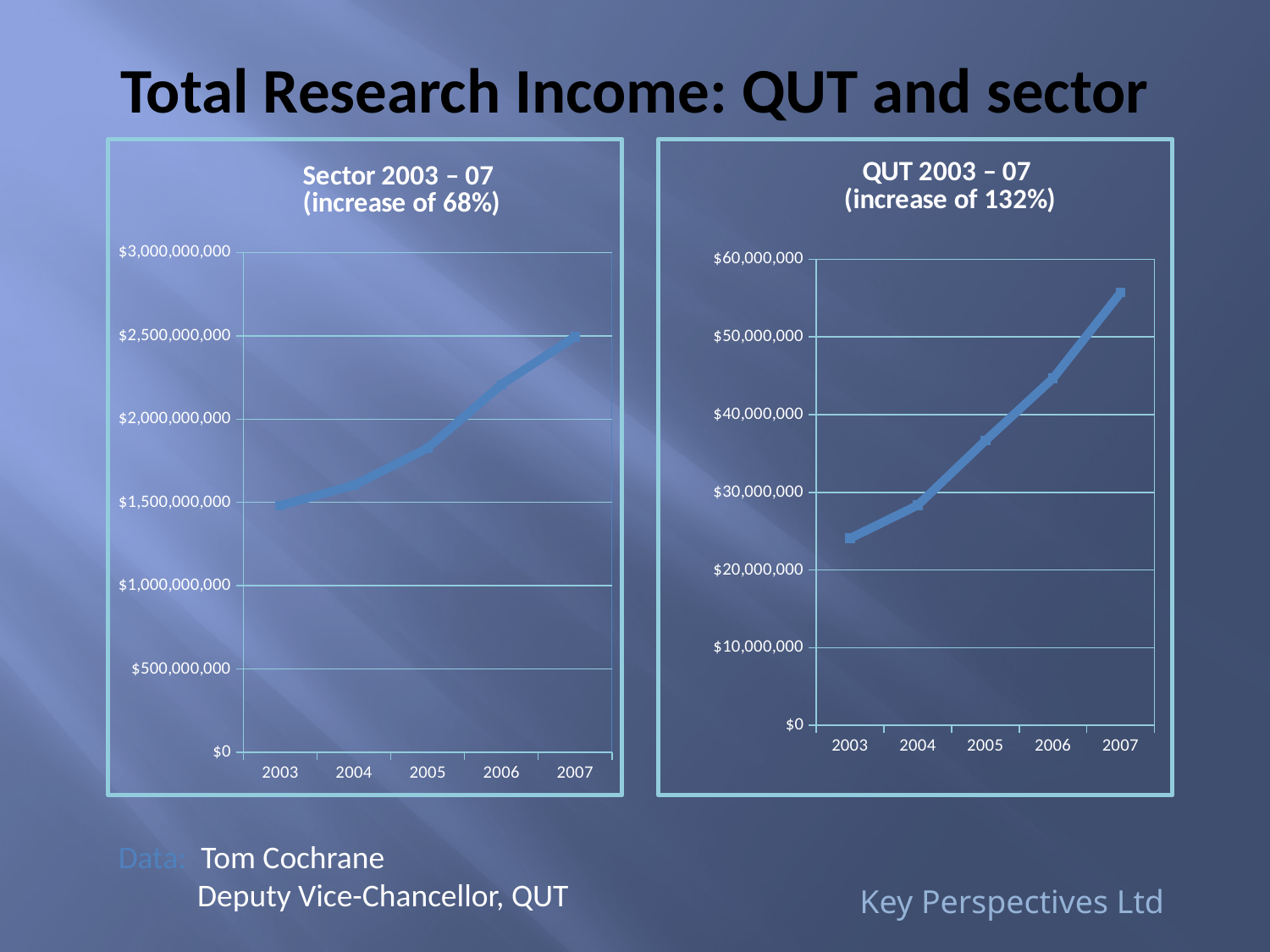
In the Sector 2003 – 07 chart, is the value for 2006 greater or less than $2,000,000,000? greater In the Sector 2003 – 07 chart, which year has the lowest value? 2003 In the Sector 2003 – 07 chart, is the value for 2005 greater or less than $2,000,000,000? less In the Sector 2003 – 07 chart, do the values rise or fall from 2003 to 2007? rise In the QUT 2003 – 07 chart, is the value for 2004 greater or less than $30,000,000? less In the QUT 2003 – 07 chart, which year has the highest value? 2007 In the QUT 2003 – 07 chart, which is larger, the value for 2005 or the value for 2003? 2005 What kind of chart is the Sector 2003 – 07 chart on the left? line chart What percentage increase does the title of the QUT 2003 – 07 chart state? 132% How many years are plotted on the QUT 2003 – 07 chart on the right? 5